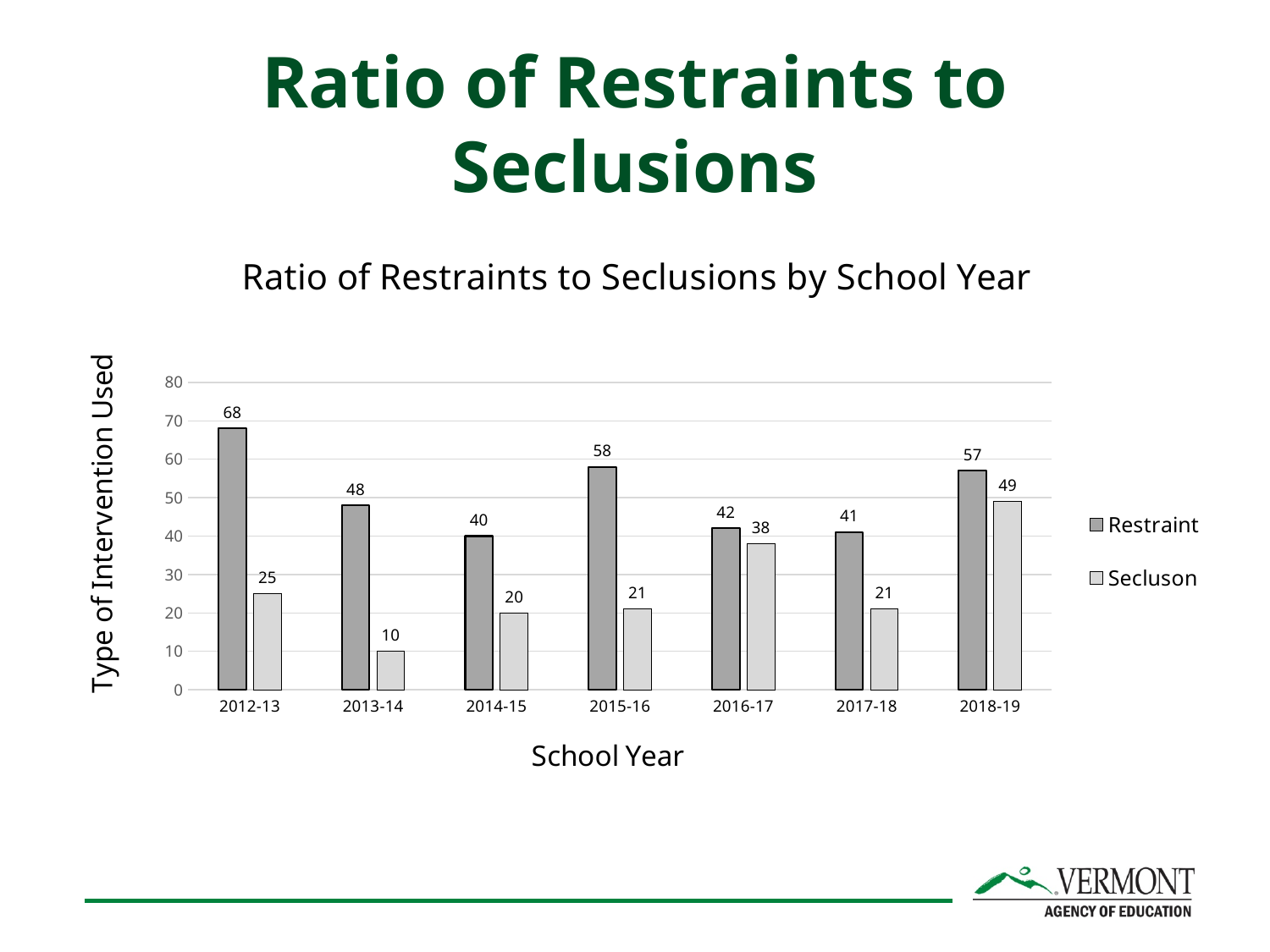
What is the Restraint value for 2012-13? 68 What is the Secluson value for 2018-19? 49 Which is larger in 2016-17, the Restraint value or the Secluson value? Restraint What is the difference between the Restraint and Secluson values in 2015-16? 37 What kind of chart is shown on the slide? bar chart What is the title of the chart? Ratio of Restraints to Seclusions by School Year Is the Restraint value for 2017-18 greater or less than 50? less What is the Secluson value for 2013-14? 10 Which school year has the highest Restraint value? 2012-13 Which school year has the lowest Secluson value? 2013-14 How many school years are shown on the x axis? 7 How many series does the legend list? 2